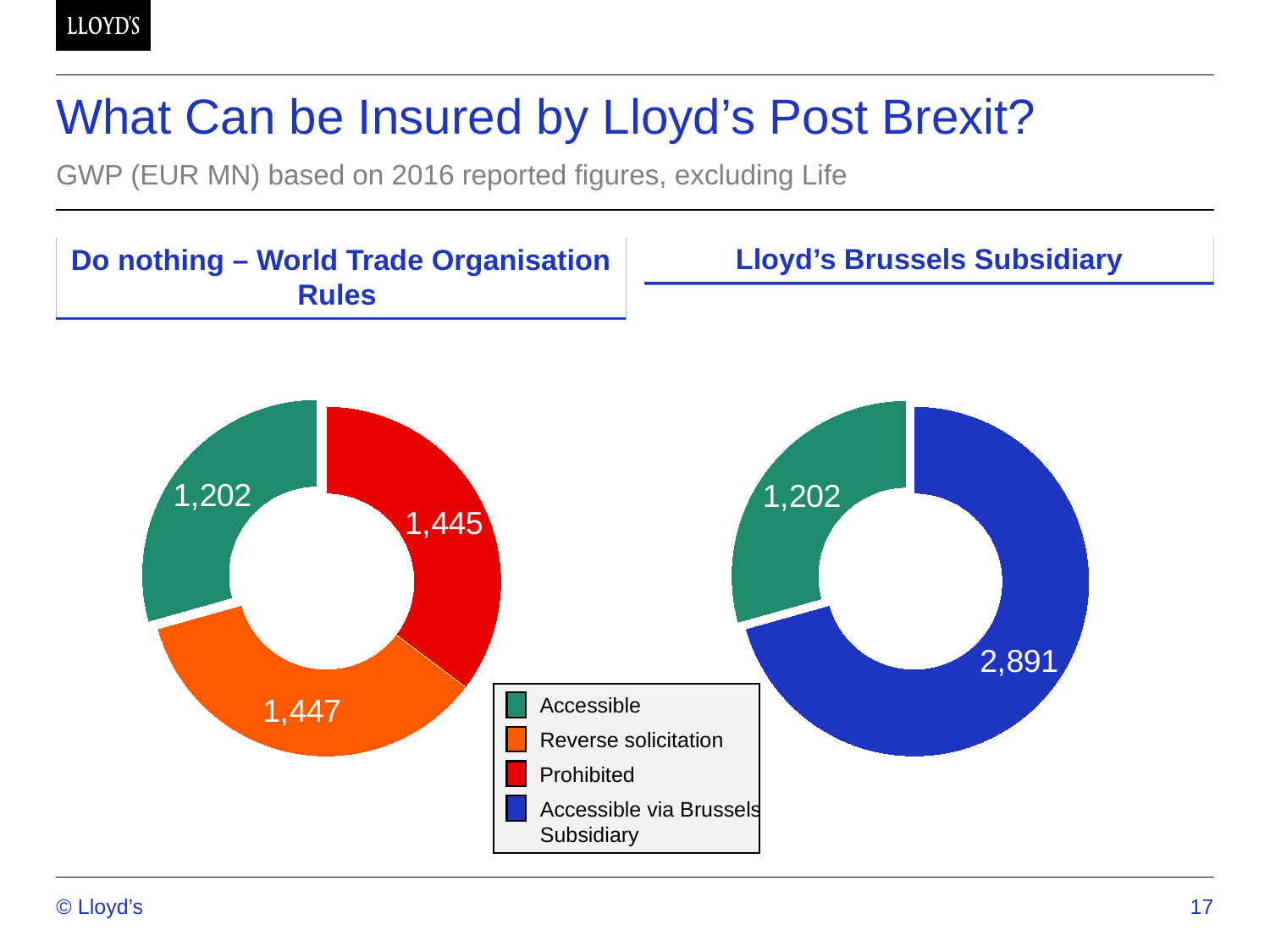
What is the total of all segments in the 'Do nothing – World Trade Organisation Rules' chart? 4,094 In the 'Do nothing – World Trade Organisation Rules' chart, which category has the smallest value? Accessible In the 'Do nothing – World Trade Organisation Rules' chart, which is larger: Reverse solicitation or Accessible? Reverse solicitation In the 'Lloyd's Brussels Subsidiary' chart, what is the difference between Accessible via Brussels Subsidiary and Accessible? 1,689 In the 'Lloyd's Brussels Subsidiary' chart, what is the value for Accessible? 1,202 How many categories are shown in the 'Lloyd's Brussels Subsidiary' chart? 2 In the 'Do nothing – World Trade Organisation Rules' chart, what is the value for Reverse solicitation? 1,447 In the 'Lloyd's Brussels Subsidiary' chart, which category has the largest value? Accessible via Brussels Subsidiary How many entries does the shared legend list? 4 In the 'Lloyd's Brussels Subsidiary' chart, what is the value for Accessible via Brussels Subsidiary? 2,891 How many categories are shown in the 'Do nothing – World Trade Organisation Rules' chart? 3 In the 'Do nothing – World Trade Organisation Rules' chart, what is the value for Prohibited? 1,445